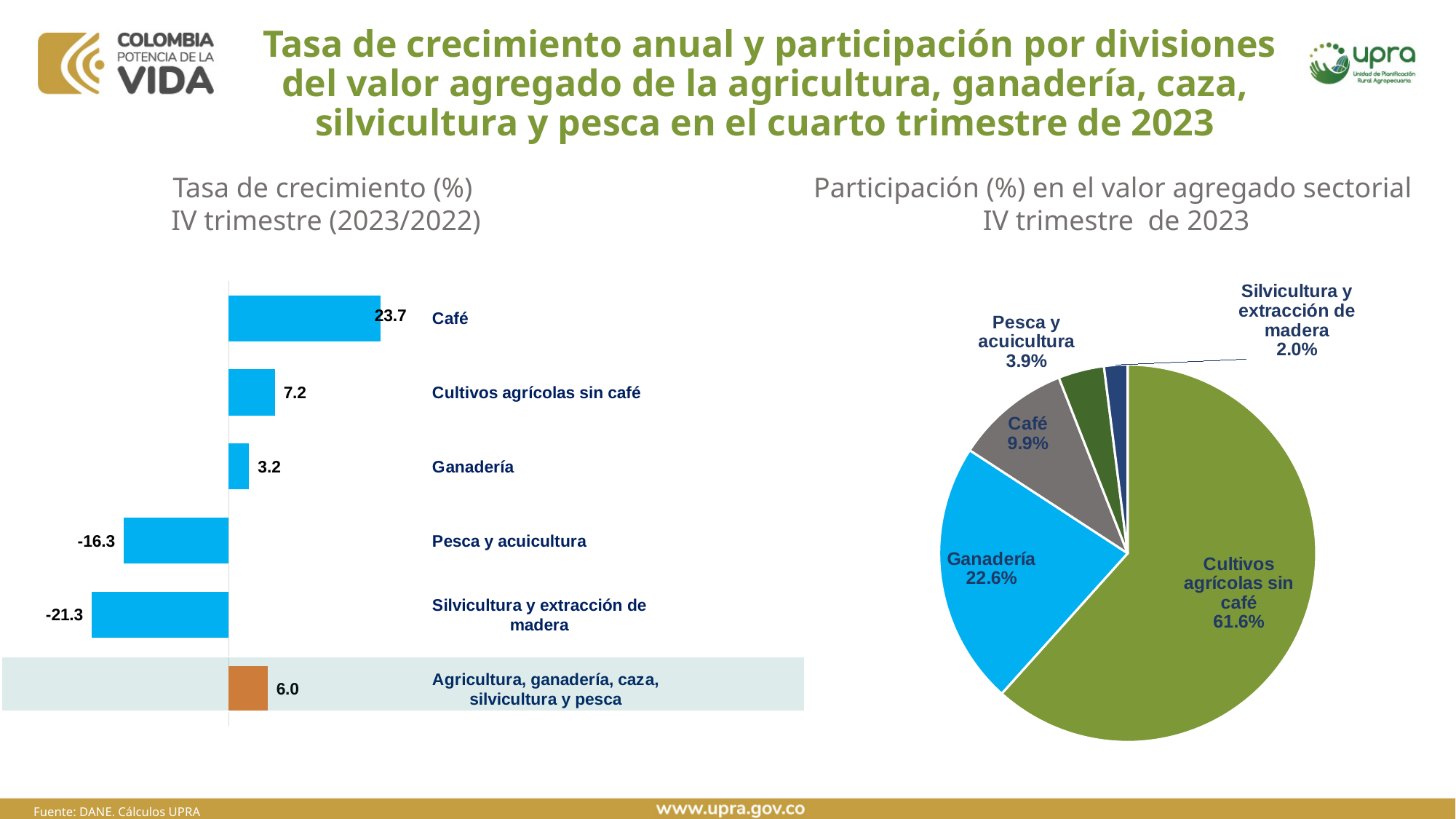
In the 'Tasa de crecimiento (%) IV trimestre (2023/2022)' chart, what is the growth rate for Silvicultura y extracción de madera? -21.3 In the 'Participación (%) en el valor agregado sectorial IV trimestre de 2023' pie chart, which category has the smallest share? Silvicultura y extracción de madera In the 'Participación (%) en el valor agregado sectorial IV trimestre de 2023' pie chart, what share does Ganadería have? 22.6% In the 'Tasa de crecimiento (%) IV trimestre (2023/2022)' chart, which category has the lowest growth rate? Silvicultura y extracción de madera In the 'Tasa de crecimiento (%) IV trimestre (2023/2022)' chart, what is the growth rate for Café? 23.7 In the 'Tasa de crecimiento (%) IV trimestre (2023/2022)' chart, which category has the highest growth rate? Café In the 'Participación (%) en el valor agregado sectorial IV trimestre de 2023' pie chart, which category has the largest share? Cultivos agrícolas sin café How many categories are shown in the 'Tasa de crecimiento (%) IV trimestre (2023/2022)' bar chart? 6 In the 'Tasa de crecimiento (%) IV trimestre (2023/2022)' chart, what is the difference between the growth rates of Café and Cultivos agrícolas sin café? 16.5 In the 'Tasa de crecimiento (%) IV trimestre (2023/2022)' chart, which is larger: the growth rate for Ganadería or for Cultivos agrícolas sin café? Cultivos agrícolas sin café What type of chart is the 'Tasa de crecimiento (%) IV trimestre (2023/2022)' chart? Bar chart In the 'Tasa de crecimiento (%) IV trimestre (2023/2022)' chart, which bar is coloured orange instead of blue? Agricultura, ganadería, caza, silvicultura y pesca